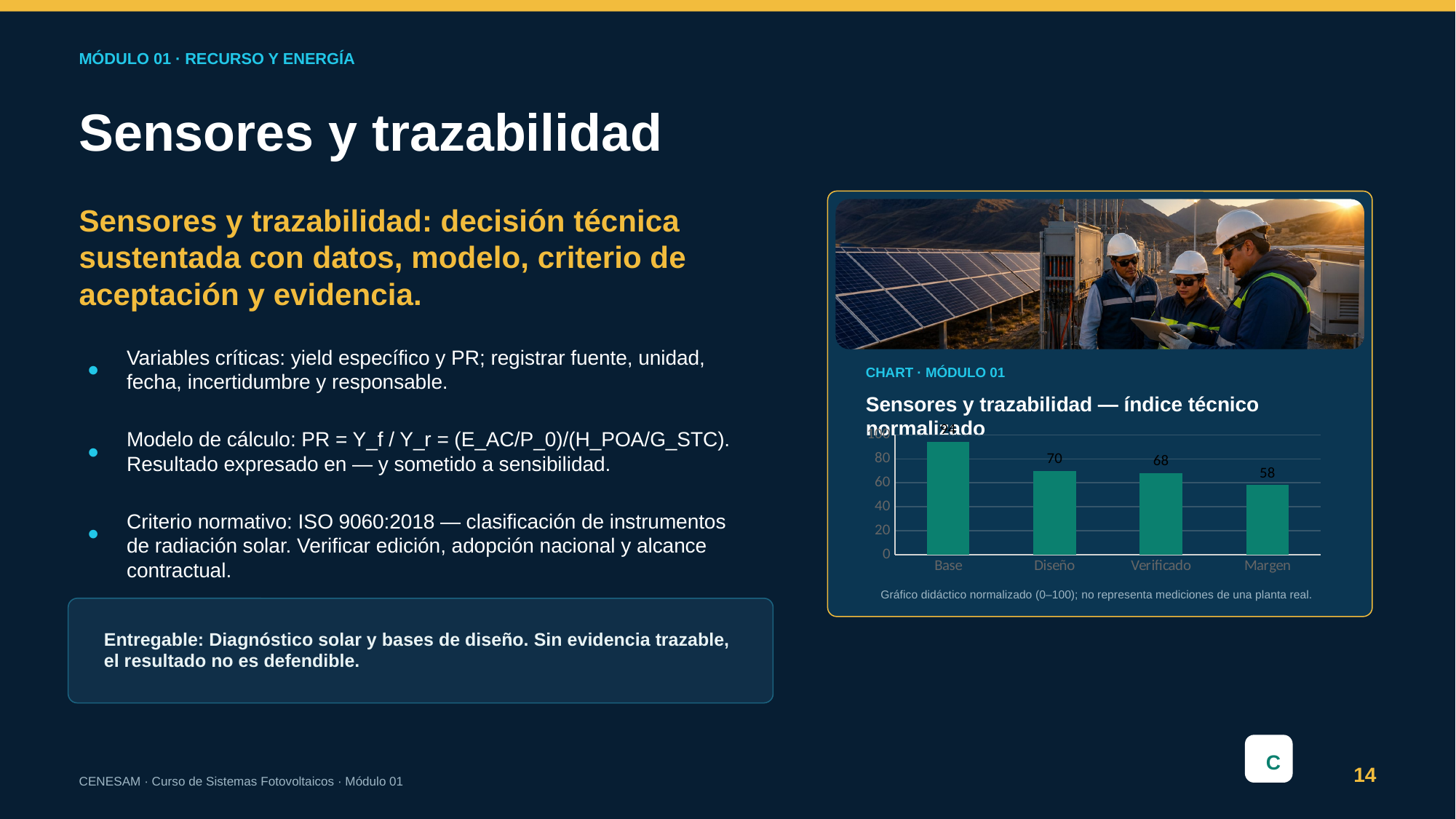
How many categories are shown on the x axis of the chart? 4 What is the value for Diseño in the chart? 70 What is the difference between the values for Diseño and Margen? 12 What is the value for Margen in the chart? 58 Which is larger, the value for Diseño or the value for Verificado? Diseño What kind of chart is shown on the slide? Bar chart What is the difference between the values for Verificado and Margen? 10 Which category has the lowest value in the chart? Margen Do the values rise or fall from Base to Margen along the x axis? Fall Which category has the highest value in the chart? Base What is the value for Verificado in the chart? 68 Is the value for Base greater or less than 80? greater